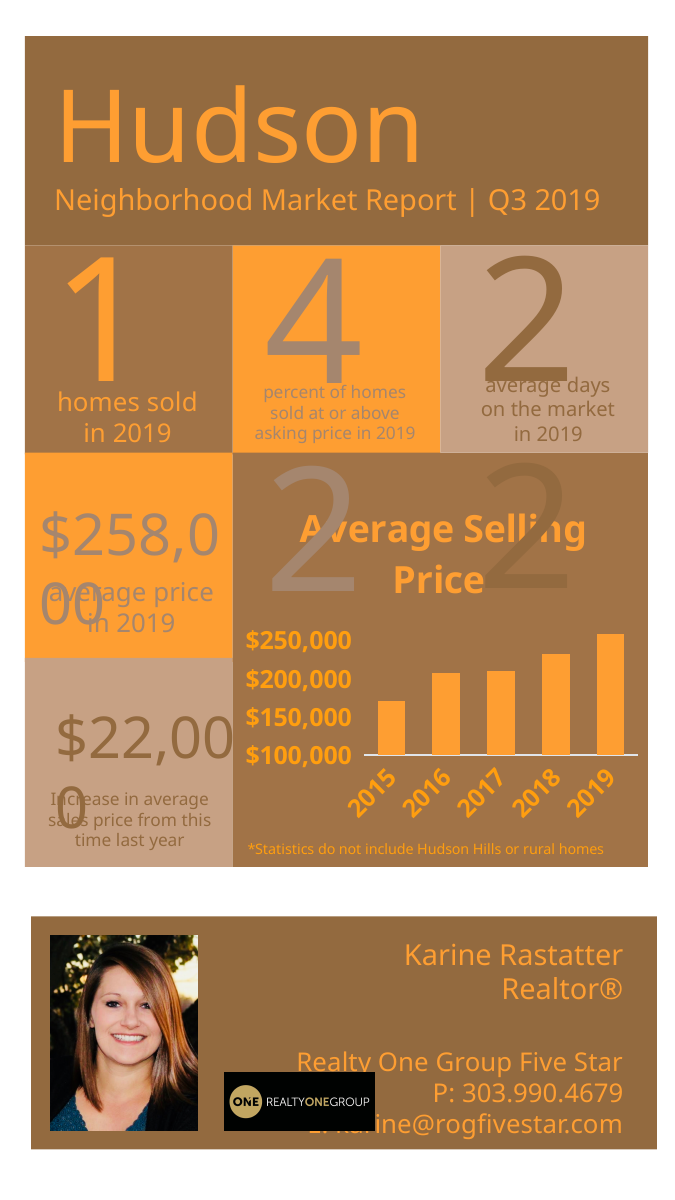
What is the title of the chart? Average Selling Price Is the average selling price for 2018 greater or less than $200,000? greater Is the average selling price for 2015 greater or less than $200,000? less What type of chart is shown on the slide? bar chart Which year has the highest average selling price in the chart? 2019 Do the average selling prices rise or fall from 2015 to 2019? rise Which year has the lowest average selling price in the chart? 2015 How many years are plotted on the x axis of the Average Selling Price chart? 5 Which year has a higher average selling price, 2015 or 2018? 2018 Is the average selling price for 2016 greater or less than $250,000? less What is the lowest value labelled on the y axis of the chart? $100,000